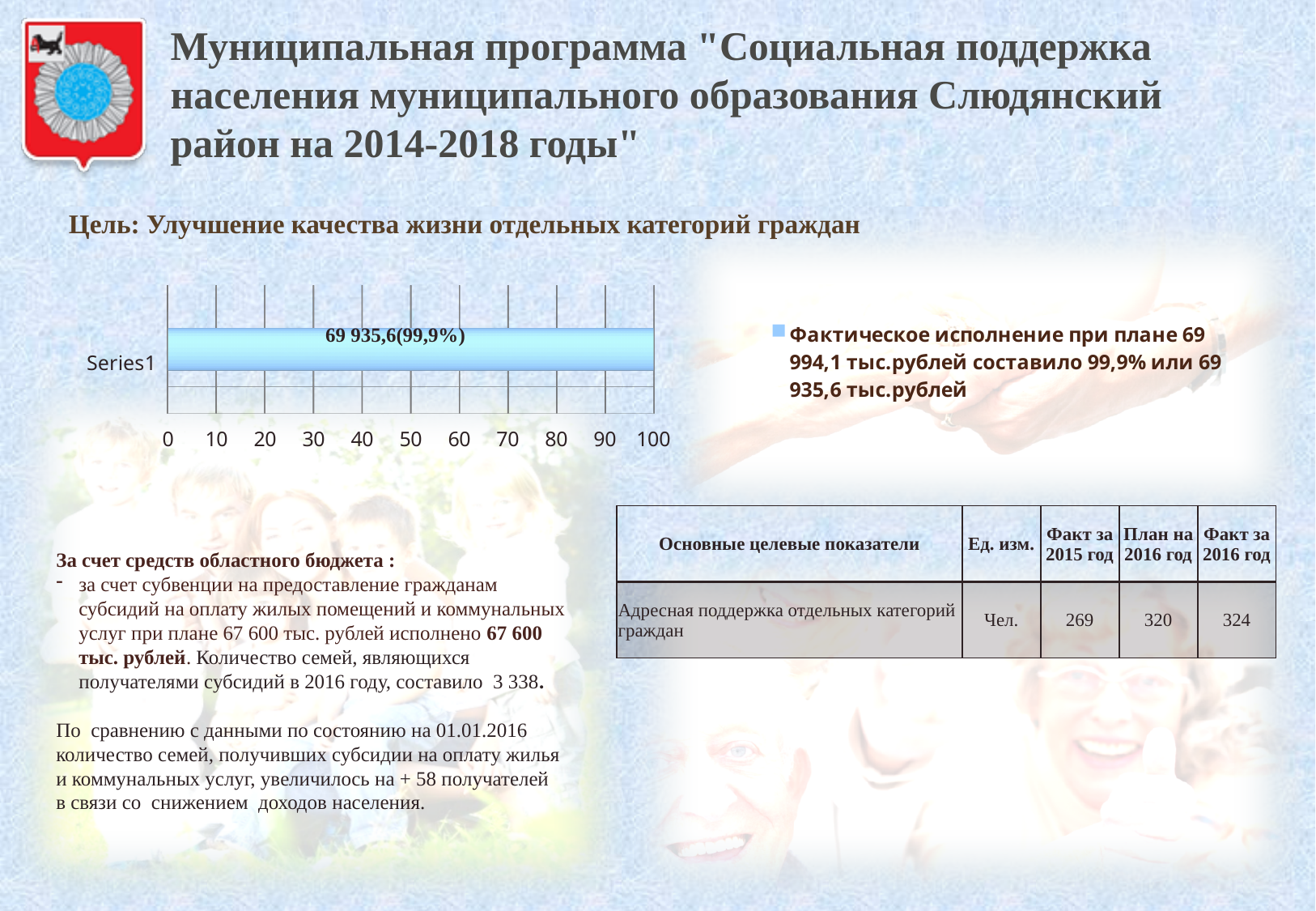
What is the data label printed on the bar in the chart? 69 935,6(99,9%) What kind of chart is shown on the slide? bar chart What percentage is shown in parentheses in the bar's data label? 99,9% What is the category label shown on the vertical axis of the chart? Series1 Is the value for Series1 greater or less than 90 on the chart's axis? greater Is the value for Series1 greater or less than 50 on the chart's axis? greater What is the highest tick value shown on the horizontal axis of the chart? 100 How many bars are plotted in the chart? 1